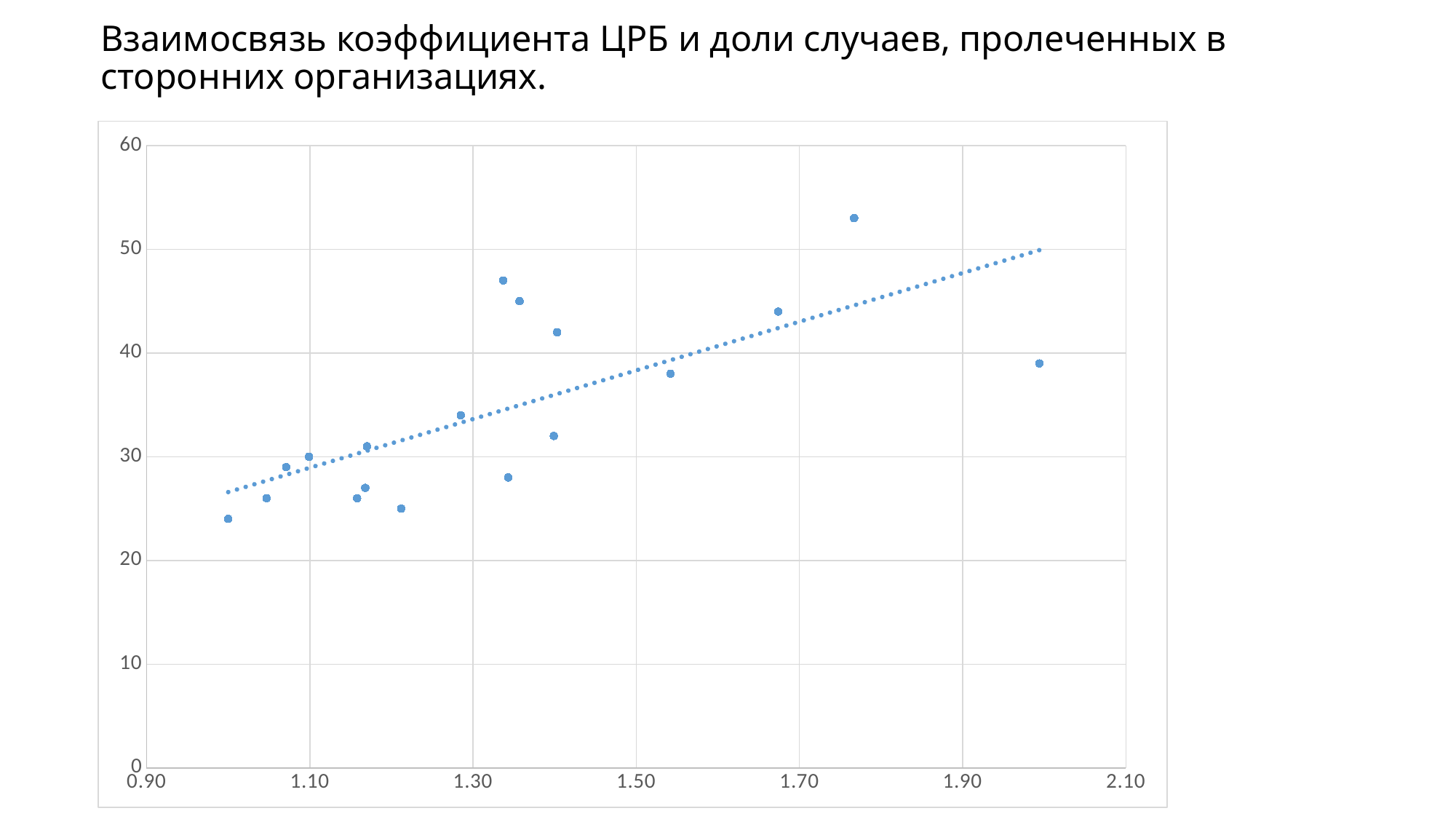
Is the highest plotted point located to the left or to the right of 1.70 on the horizontal axis? right Is the lowest plotted point greater or less than 30 on the vertical axis? less Is the highest plotted point greater or less than 50 on the vertical axis? greater What is the title of the chart? Взаимосвязь коэффициента ЦРБ и доли случаев, пролеченных в сторонних организациях. How many data points are plotted on the chart? 18 What is the maximum value shown on the vertical axis? 60 Is the lowest plotted point located to the left or to the right of 1.10 on the horizontal axis? left Does the dotted trend line rise or fall as the x value increases? Rises Is the value of the point near x = 1.54 greater or less than 40? less What kind of chart is shown on the slide? Scatter chart